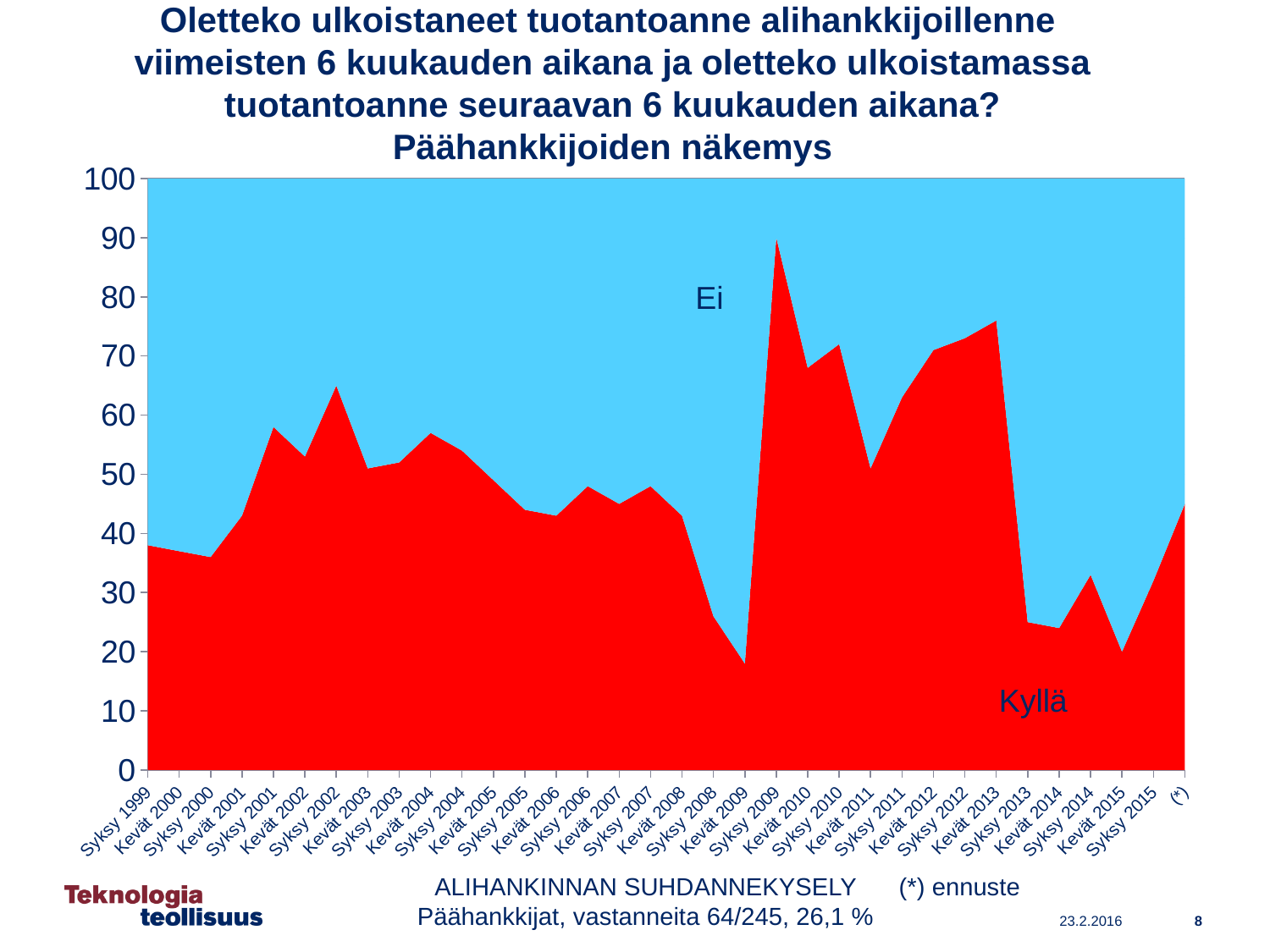
How many series are shown in the chart? 2 Is the Kyllä value for Kevät 2009 greater or less than 20? less At which time point is the Kyllä share highest? Syksy 2009 Does the Kyllä share rise or fall from Kevät 2013 to Syksy 2013? fall At which time point is the Kyllä share lowest? Kevät 2009 What are the names of the two series labelled in the chart? Ei and Kyllä Which is larger, the Kyllä value for Syksy 2009 or for Kevät 2009? Syksy 2009 How many time points are shown on the x axis? 34 Is the Kyllä value for Syksy 2009 greater or less than 80? greater Is the Kyllä value for Kevät 2013 greater or less than 70? greater What kind of chart is shown on the slide? area chart